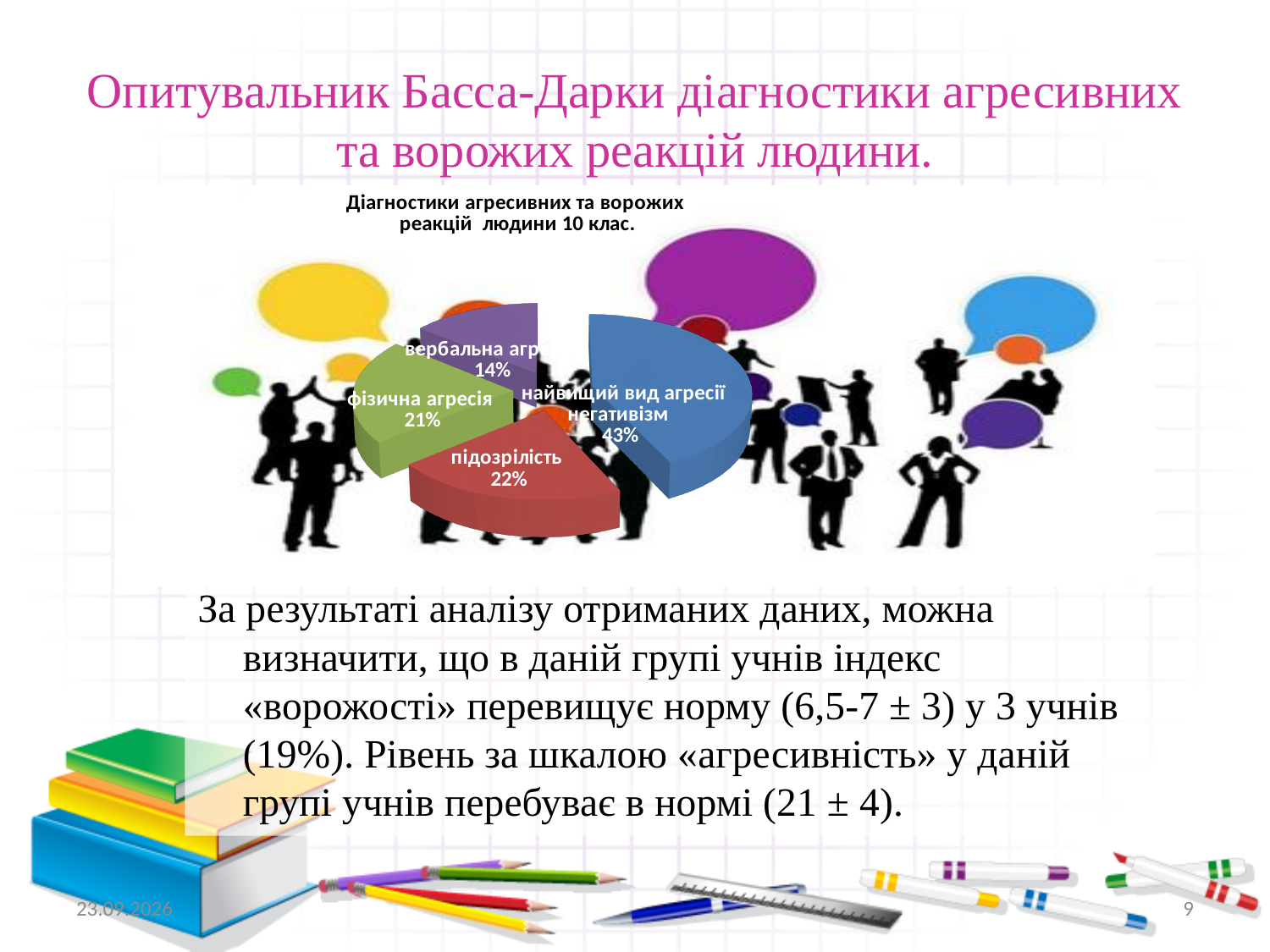
Which slice of the pie chart is the largest? негативізм What percentage is shown for підозрілість? 22% Which slice of the pie chart is the smallest? вербальна агресія What percentage is shown for негативізм in the pie chart? 43% What is the title of the pie chart? Діагностики агресивних та ворожих реакцій людини 10 клас. What is the difference in percentage points between негативізм and підозрілість? 21 What kind of chart is shown on the slide? pie chart What percentage is shown for вербальна агресія? 14% What percentage is shown for фізична агресія? 21% Which is larger, the share for підозрілість or the share for фізична агресія? підозрілість What colour is the негативізм slice of the pie chart? blue How many slices does the pie chart have? 4